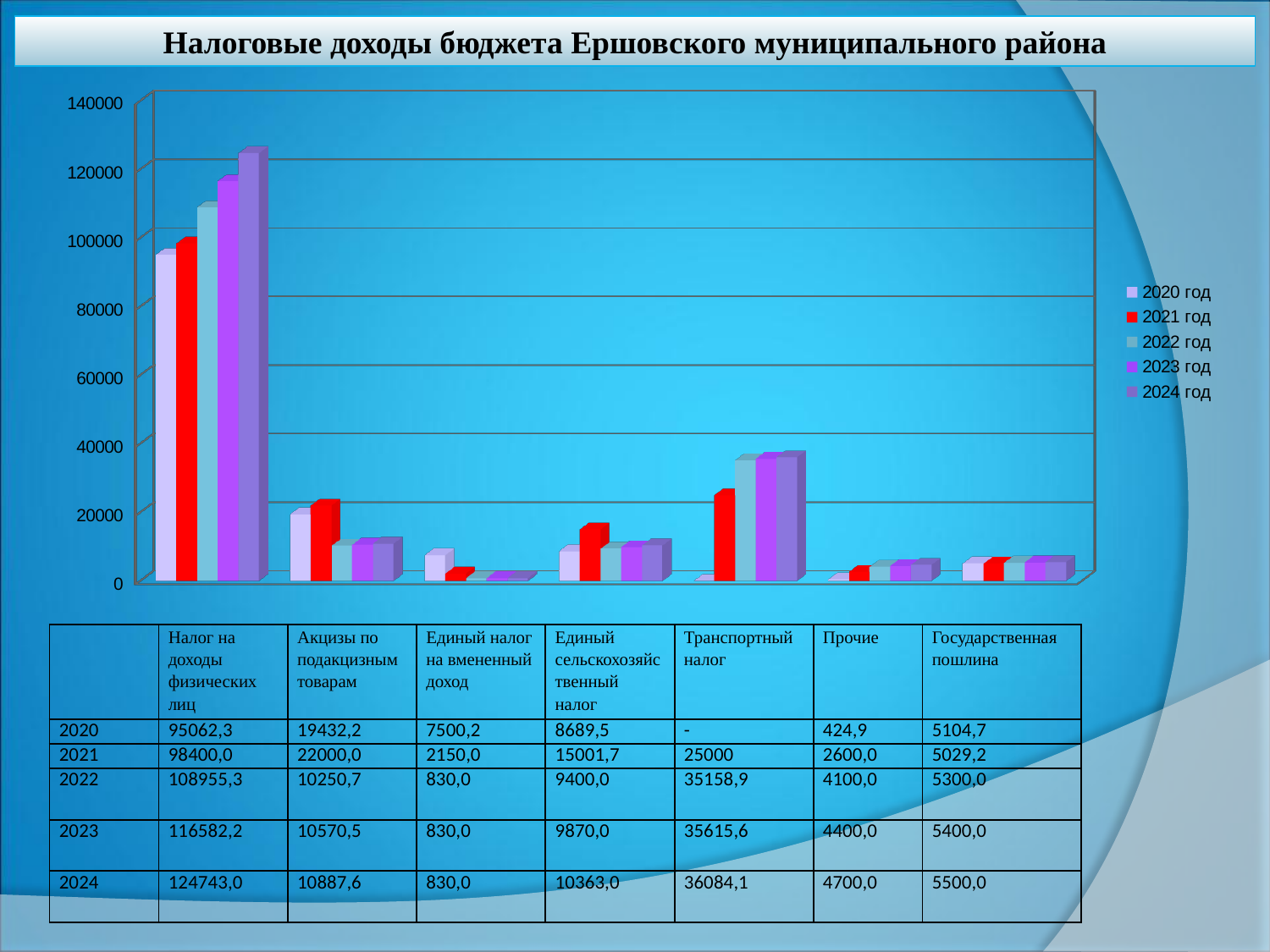
Is the 2024 value for Транспортный налог greater or less than 40000? less How many tax categories are plotted in the chart? 7 What is the value of Налог на доходы физических лиц for 2024? 124743,0 Which is larger for Акцизы по подакцизным товарам: the 2021 value or the 2022 value? 2021 What is the value of Государственная пошлина for 2023? 5400,0 Do the values for Налог на доходы физических лиц rise or fall from 2020 to 2024? rise What is the value of Транспортный налог for 2021? 25000 What kind of chart is shown on the slide? bar chart What is the difference between the 2024 and 2020 values for Налог на доходы физических лиц? 29680,7 Which year has the highest value for Налог на доходы физических лиц? 2024 год What is the first entry in the chart legend? 2020 год How many series does the legend list? 5